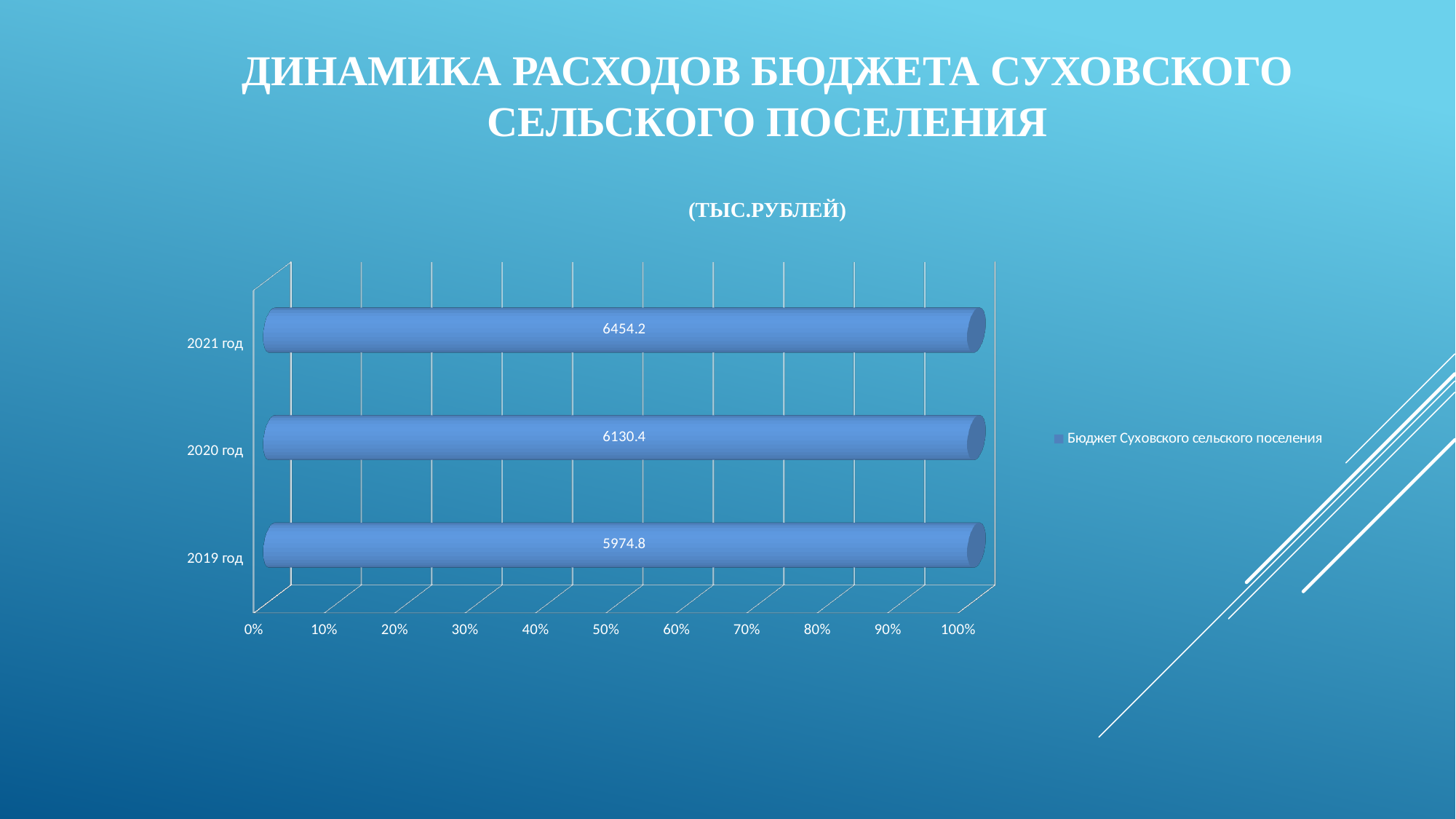
How many years (categories) are shown in the chart? 3 Which year has the highest labelled value? 2021 год What is the value labelled on the bar for 2019 год? 5974.8 What kind of chart is shown on the slide? Bar chart Which is larger, the labelled value for 2020 год or for 2019 год? 2020 год How many series does the legend list? 1 What is the value labelled on the bar for 2020 год? 6130.4 What is the difference between the labelled values for 2020 год and 2019 год? 155.6 Do the labelled values rise or fall from 2019 год to 2021 год? Rise What is the difference between the labelled values for 2021 год and 2020 год? 323.8 Which year has the lowest labelled value? 2019 год What is the value labelled on the bar for 2021 год? 6454.2